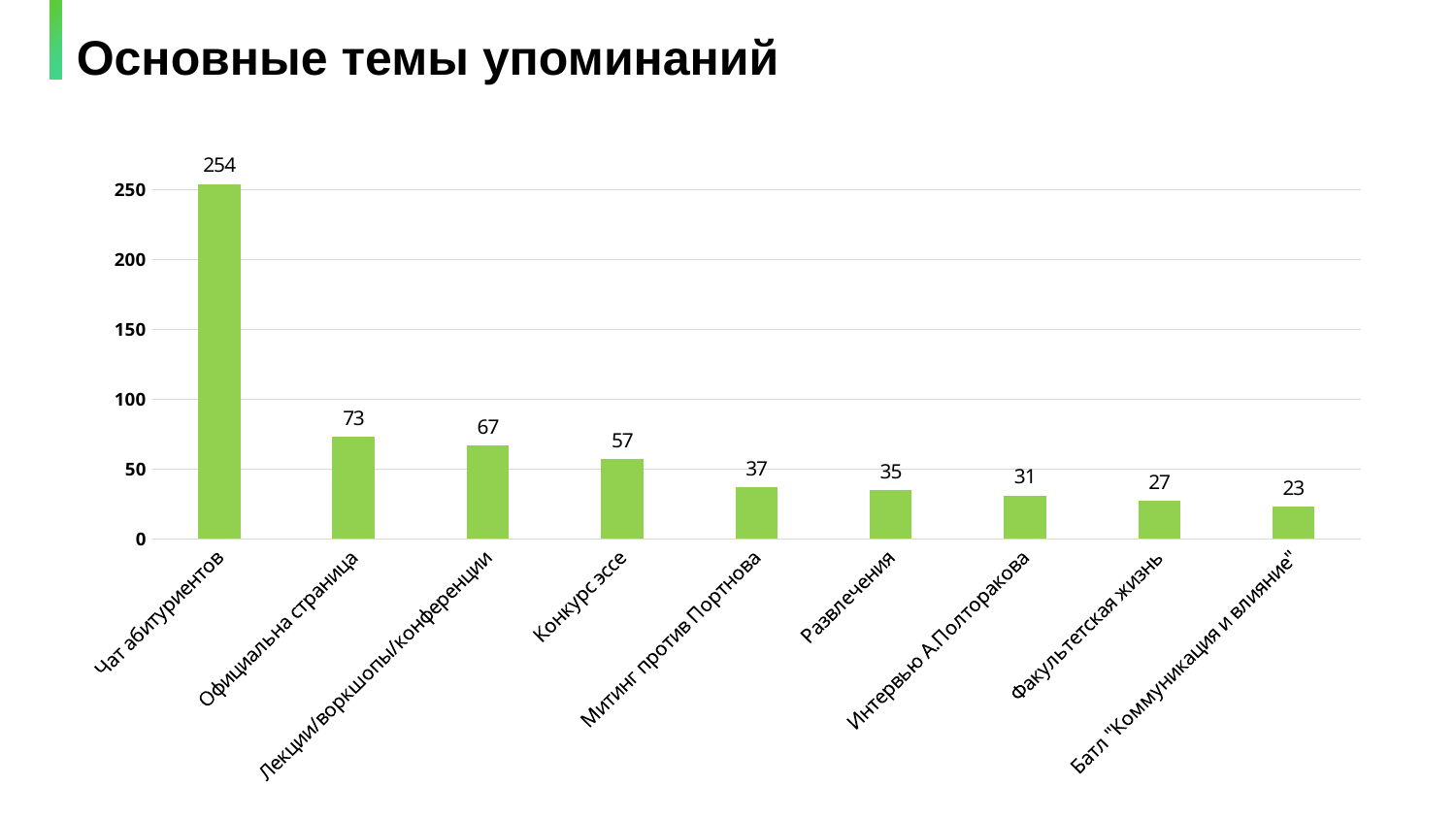
What is the value for Чат абитуриентов? 254 Which category has the highest value? Чат абитуриентов Which is larger, the value for Митинг против Портнова or the value for Факультетская жизнь? Митинг против Портнова How many categories are shown on the chart? 9 What is the title of the slide? Основные темы упоминаний What is the value for Интервью А.Полторакова? 31 What is the difference between the values for Официальна страница and Лекции/воркшопы/конференции? 6 Which category has the lowest value? Батл "Коммуникация и влияние" What is the difference between the values for Чат абитуриентов and Официальна страница? 181 What is the value for Конкурс эссе? 57 Is the value for Развлечения greater or less than 50? less What kind of chart is shown on the slide? bar chart